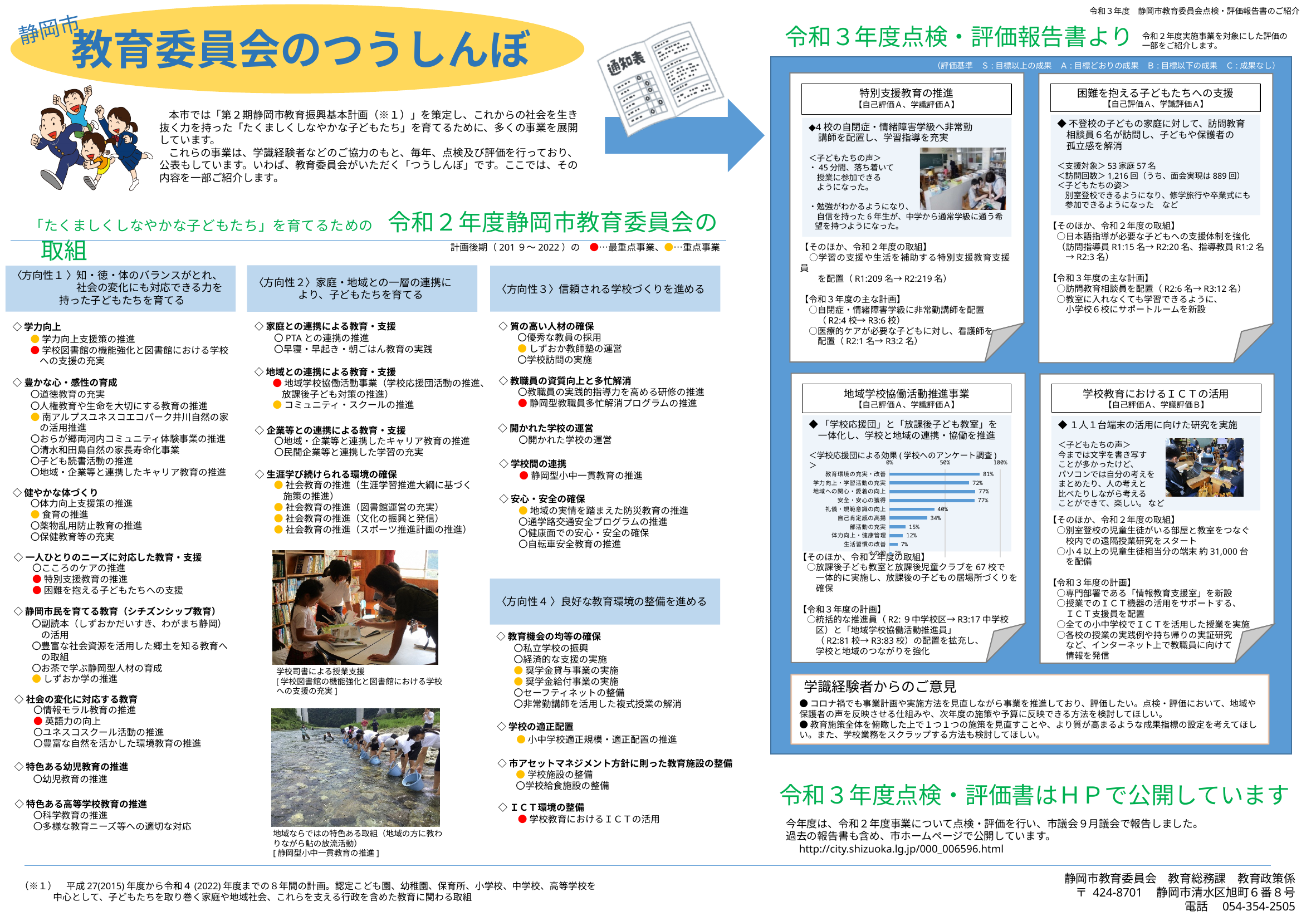
In the bar chart titled 学校応援団による効果, which is larger, 礼儀・規範意識の向上 or 自己肯定感の高揚? 礼儀・規範意識の向上 In the bar chart titled 学校応援団による効果, what is the value for 学力向上・学習活動の充実? 72% In the bar chart titled 学校応援団による効果, which category has the highest value? 教育環境の充実・改善 In the bar chart titled 学校応援団による効果, what is the value for 生活習慣の改善? 7% In the bar chart titled 学校応援団による効果, what is the difference between 自己肯定感の高揚 and 体力向上・健康管理? 22% In the bar chart titled 学校応援団による効果, what is the value for 礼儀・規範意識の向上? 40% In the bar chart titled 学校応援団による効果, is the value for 安全・安心の獲得 greater or less than 50%? greater In the bar chart titled 学校応援団による効果, what is the value for 部活動の充実? 15% What is the highest tick label shown on the horizontal axis of the 学校応援団による効果 chart? 100% In the bar chart titled 学校応援団による効果, what is the value for 教育環境の充実・改善? 81% What kind of chart is the 学校応援団による効果 chart? bar chart In the bar chart titled 学校応援団による効果, what is the difference between 教育環境の充実・改善 and 学力向上・学習活動の充実? 9%